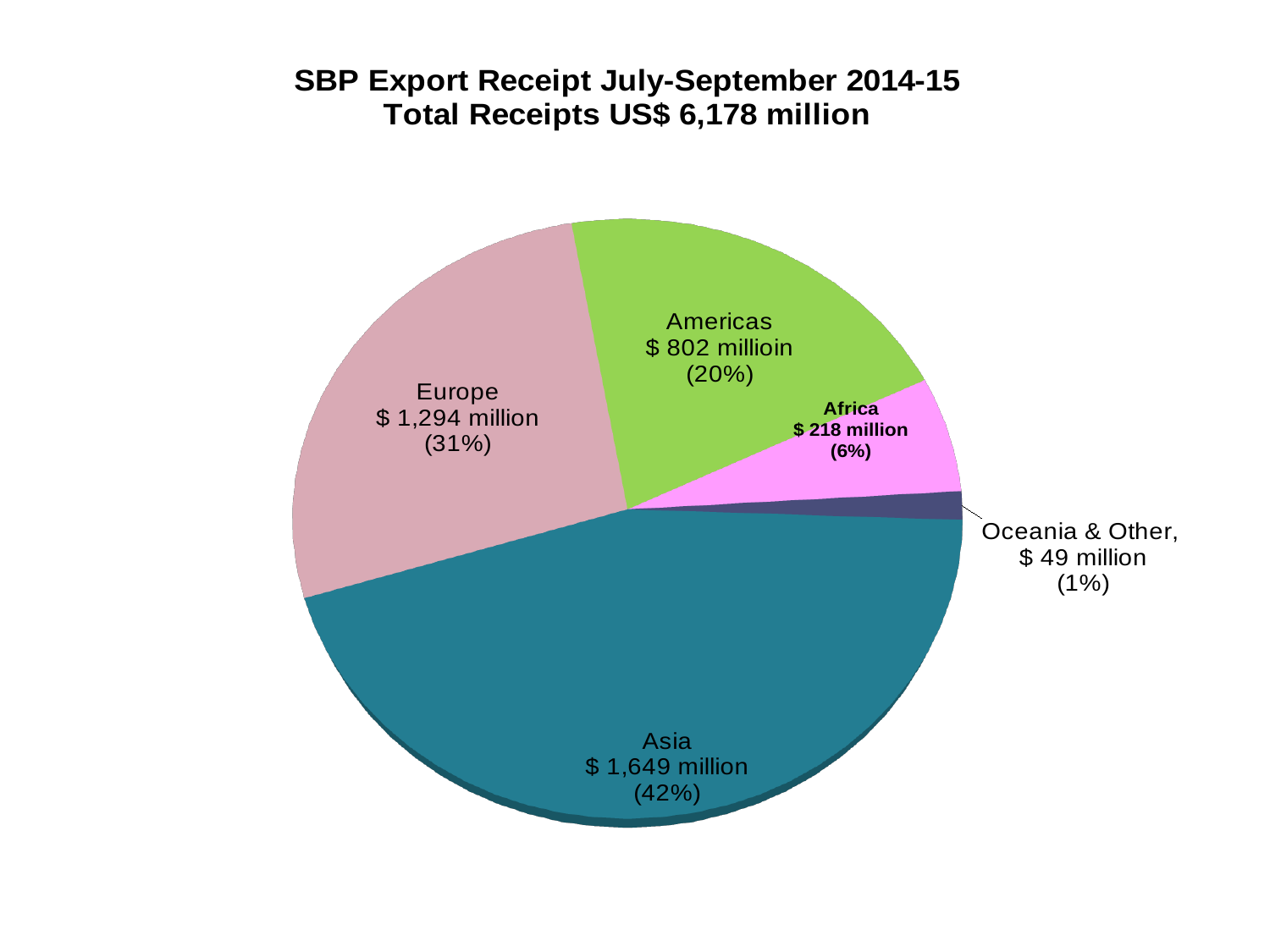
What kind of chart is shown on the slide? Pie chart Which is larger, the export receipts for Americas or for Africa? Americas What share of export receipts does the Europe slice represent? 31% What is the export receipt value for Africa? $ 218 million What share of export receipts does the Americas slice represent? 20% How many regions are shown in the pie chart? 5 What is the export receipt value for Oceania & Other? $ 49 million Which region has the largest share of export receipts? Asia What is the difference between the export receipts for Asia and Europe? $ 355 million What is the export receipt value for Asia? $ 1,649 million Which region has the smallest share of export receipts? Oceania & Other What is the export receipt value for Europe? $ 1,294 million